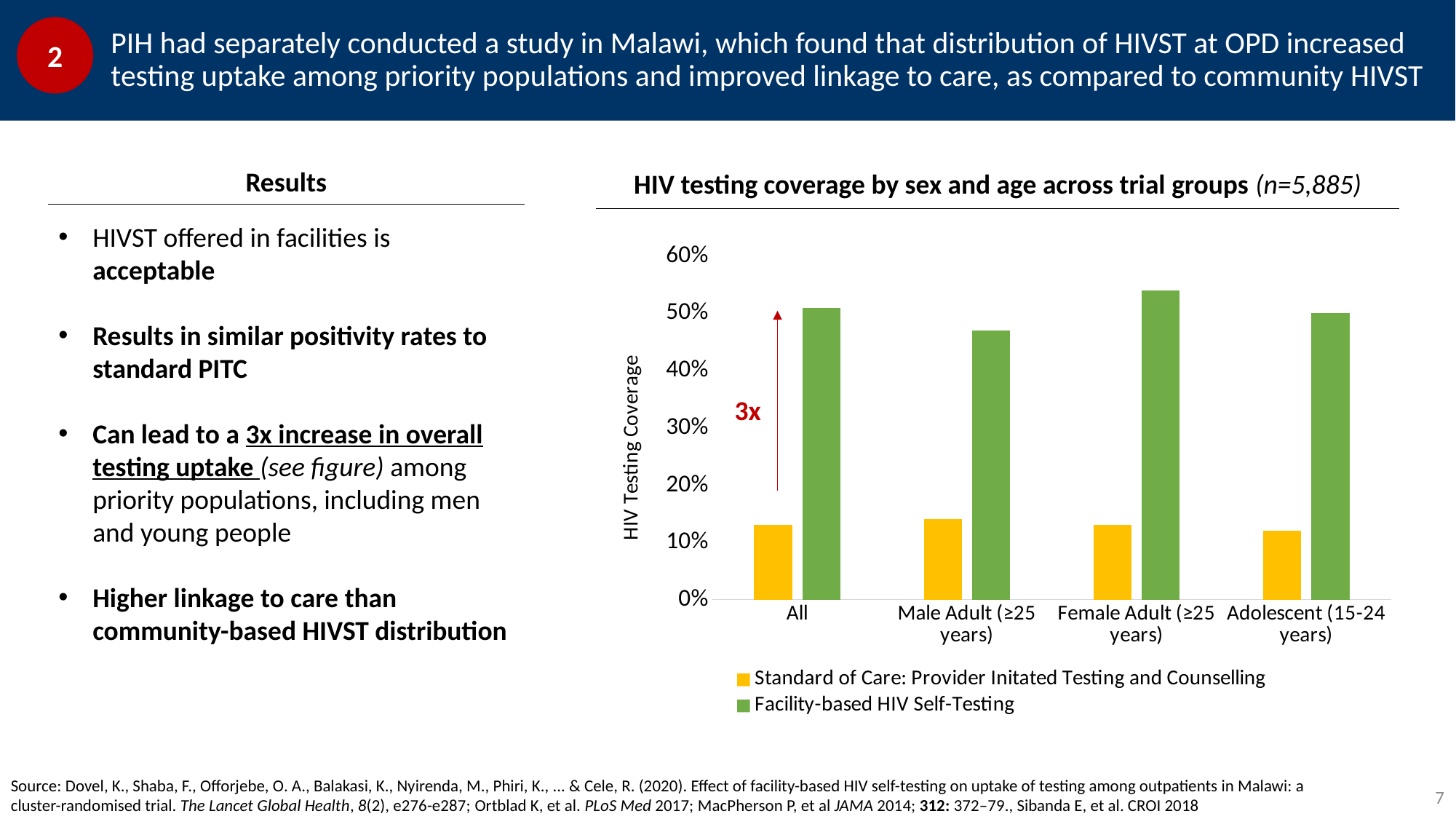
Which category has the highest Facility-based HIV Self-Testing coverage? Female Adult (≥25 years) What kind of chart is shown on the slide? Bar chart Which category has the lowest Facility-based HIV Self-Testing coverage? Male Adult (≥25 years) How many series does the chart's legend list? 2 For the All category, which series has the larger value: Standard of Care or Facility-based HIV Self-Testing? Facility-based HIV Self-Testing Is the Facility-based HIV Self-Testing value for Female Adult (≥25 years) greater or less than 50%? greater Is the Facility-based HIV Self-Testing value for All greater or less than 40%? greater Is the Facility-based HIV Self-Testing value for Male Adult (≥25 years) greater or less than 50%? less What colour represents the Facility-based HIV Self-Testing series in the chart? Green How many categories are shown on the x axis of the chart? 4